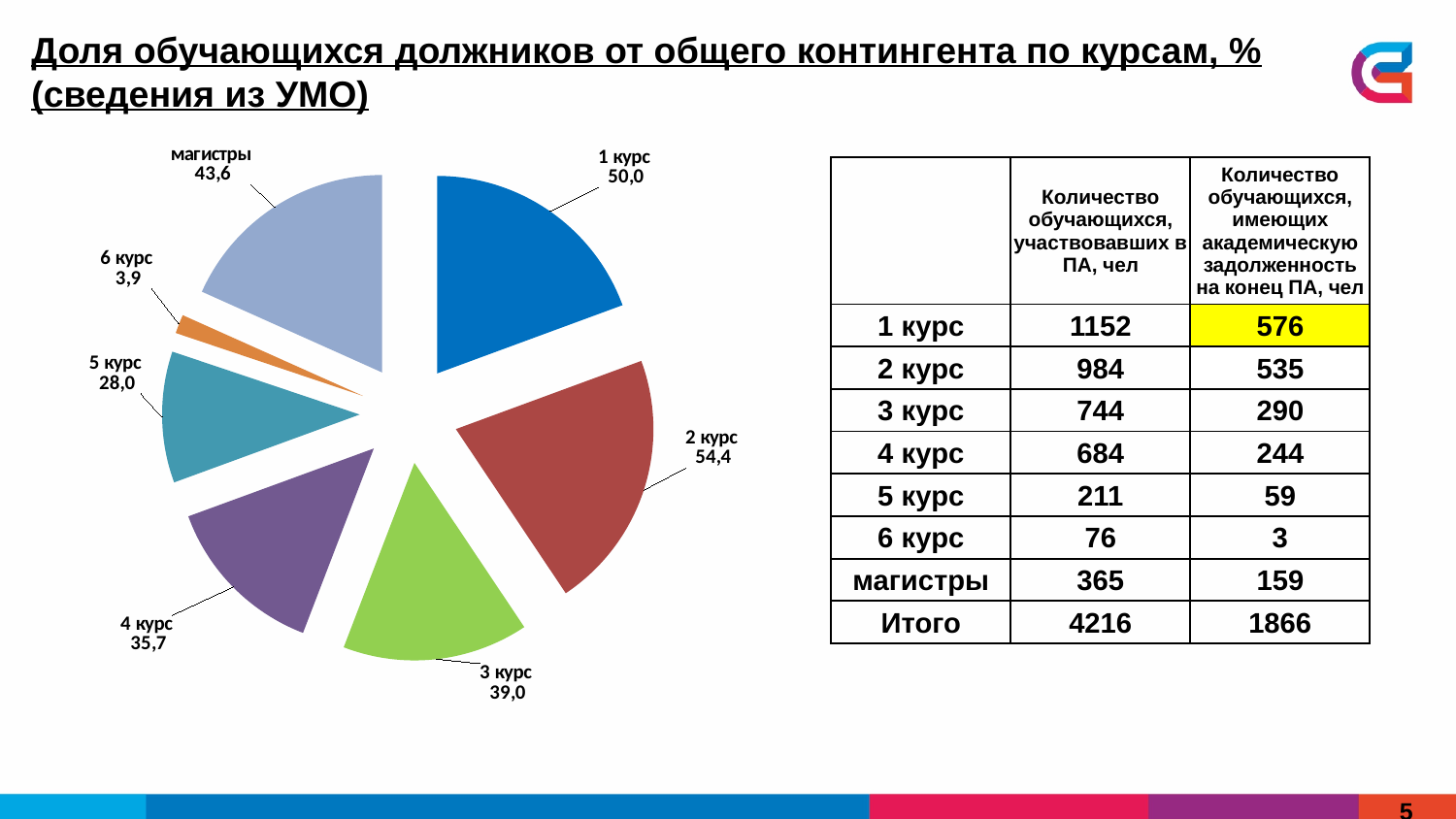
What is the difference between the values for 2 курс and 3 курс in the pie chart? 15,4 What kind of chart is shown on the slide? pie chart How many slices does the pie chart have? 7 What value is shown for 2 курс in the pie chart? 54,4 What value is shown for 4 курс in the pie chart? 35,7 What is the title of the chart on the slide? Доля обучающихся должников от общего контингента по курсам, % (сведения из УМО) What is the difference between the values for 1 курс and 5 курс in the pie chart? 22,0 Which category has the smallest value in the pie chart? 6 курс Which has the larger value in the pie chart, 3 курс or 4 курс? 3 курс Which category has the largest value in the pie chart? 2 курс What value is shown for магистры in the pie chart? 43,6 What value is shown for 6 курс in the pie chart? 3,9